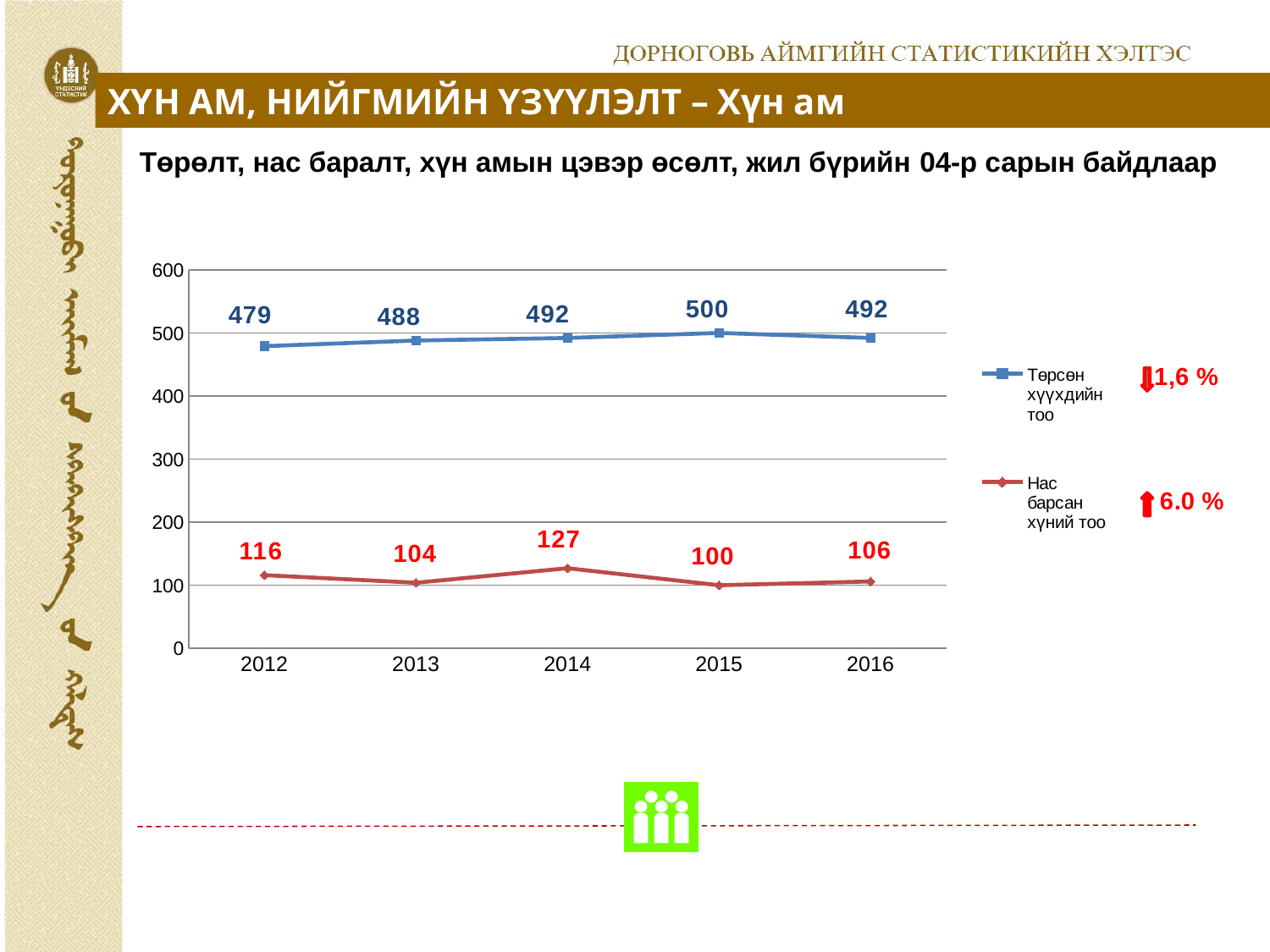
What kind of chart is shown on the slide? line chart In which year is Төрсөн хүүхдийн тоо highest? 2015 What is the value of Төрсөн хүүхдийн тоо in 2015? 500 How many years are shown on the x axis? 5 How many series does the legend list? 2 What is the value of Төрсөн хүүхдийн тоо in 2012? 479 What is the difference between Төрсөн хүүхдийн тоо and Нас барсан хүний тоо in 2016? 386 Which is larger for Нас барсан хүний тоо: 2012 or 2013? 2012 What is the value of Нас барсан хүний тоо in 2014? 127 In which year is Нас барсан хүний тоо lowest? 2015 Is the value for Төрсөн хүүхдийн тоо in 2013 greater or less than 400? greater Does Төрсөн хүүхдийн тоо rise or fall from 2012 to 2015? rise